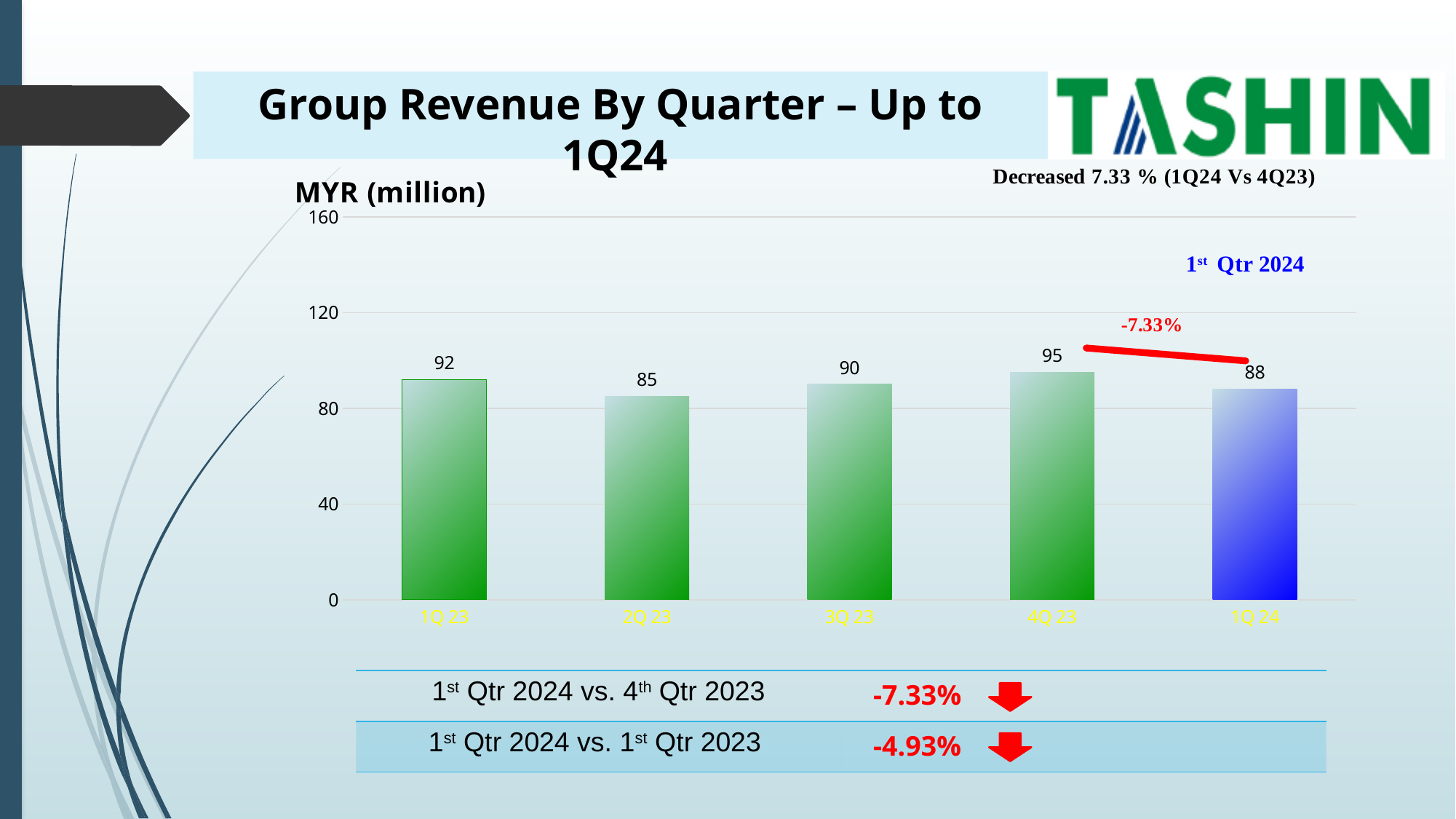
Which quarter has the lowest revenue? 2Q 23 Which is larger, the revenue for 1Q 23 or 3Q 23? 1Q 23 What is the group revenue for 4Q 23? 95 What kind of chart is shown on the slide? bar chart How many quarters are shown in the chart? 5 Which quarter has the highest revenue? 4Q 23 Is the revenue for 3Q 23 greater or less than 80? greater What unit is shown on the chart's axis label? MYR (million) What is the group revenue for 2Q 23? 85 What is the difference in revenue between 4Q 23 and 1Q 24? 7 What is the difference in revenue between 1Q 23 and 2Q 23? 7 What is the group revenue for 1Q 24? 88